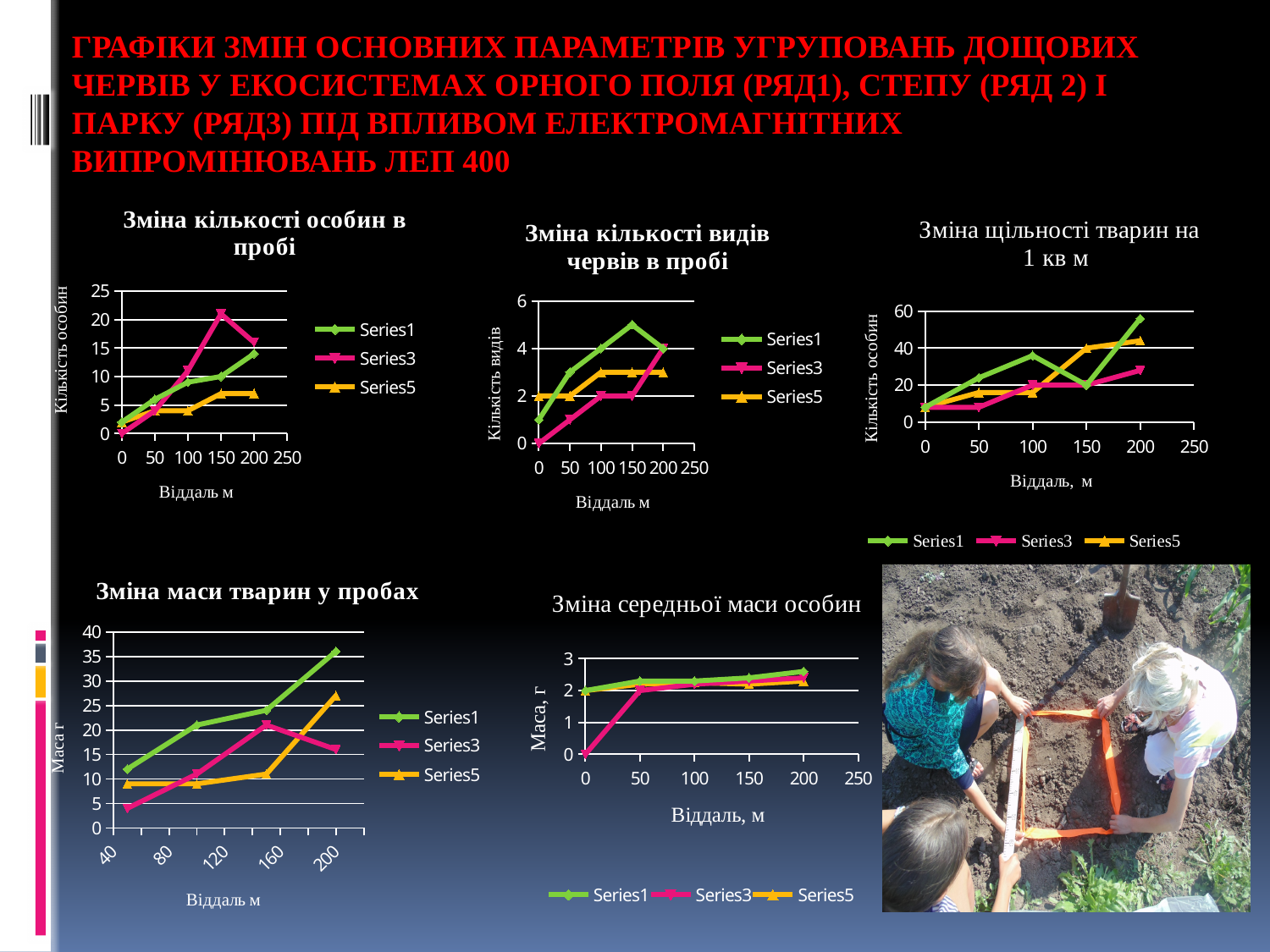
In "Зміна кількості видів червів в пробі", what is the value of Series3 at 0 m? 0 In "Зміна щільності тварин на 1 кв м", is the value of Series1 at 200 m greater or less than 40? greater In "Зміна кількості особин в пробі", is the value of Series3 at 150 m greater or less than 20? greater In "Зміна маси тварин у пробах", is the value of Series1 at 200 m greater or less than 30? greater In "Зміна кількості особин в пробі", which series has the highest value at 150 m? Series3 How many series does the legend of "Зміна кількості особин в пробі" list? 3 In "Зміна щільності тварин на 1 кв м", which is larger at 200 m: Series1 or Series3? Series1 In "Зміна середньої маси особин", what is the value of Series3 at 0 m? 0 In "Зміна маси тварин у пробах", does Series1 rise or fall along the x axis? rise What kind of chart is "Зміна кількості особин в пробі"? line chart What is the x-axis label of the chart "Зміна середньої маси особин"? Віддаль, м In "Зміна кількості видів червів в пробі", which series reaches the highest value at 150 m? Series1